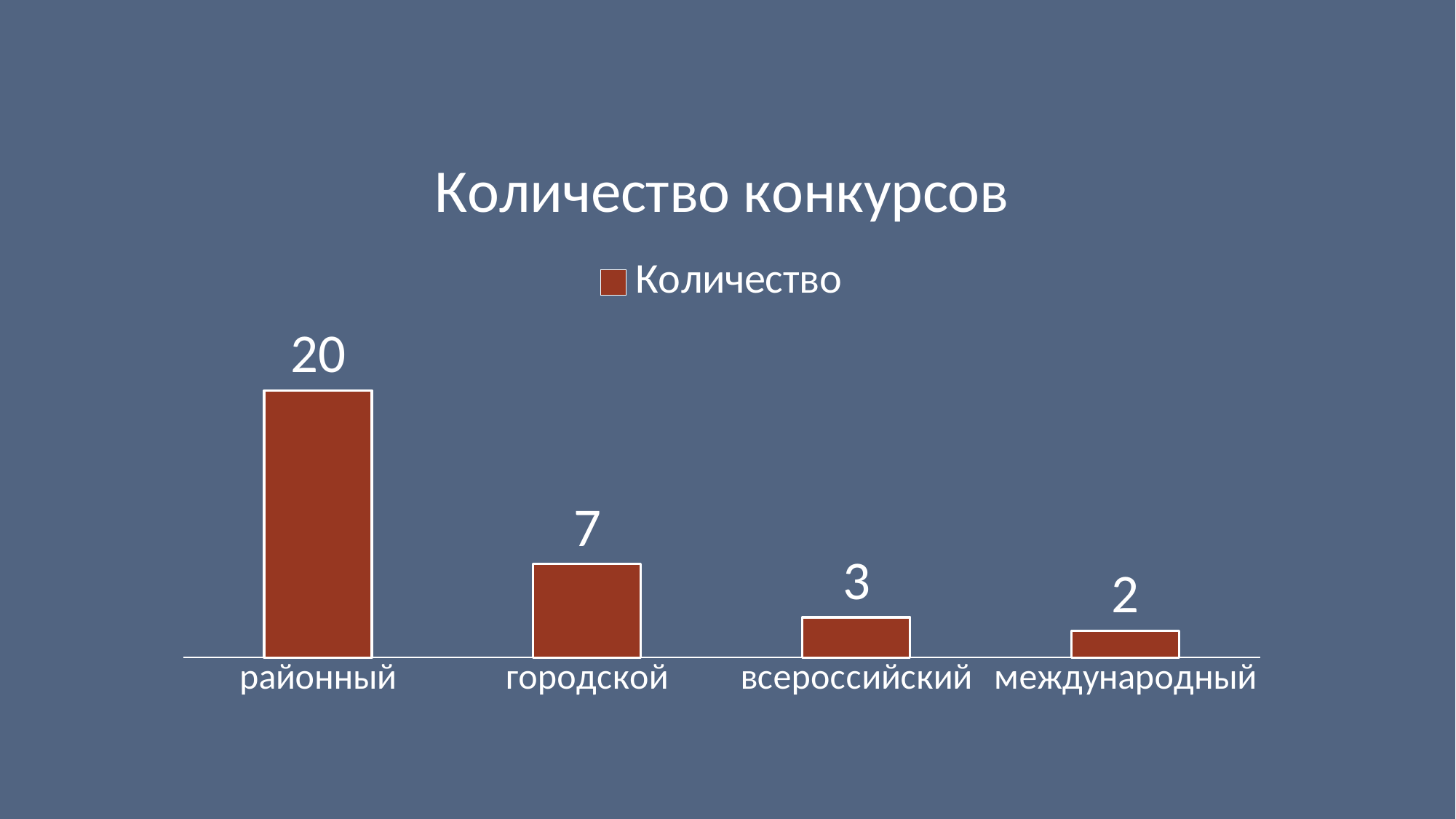
What is the value for районный? 20 What is the value for городской? 7 Which category has the lowest value? международный Which is larger, the value for городской or the value for всероссийский? городской What kind of chart is shown? bar chart How many categories are shown on the x axis? 4 Which category has the highest value? районный What is the value for всероссийский? 3 How many series does the legend list? 1 What is the difference between the values for районный and городской? 13 What is the title of the chart? Количество конкурсов What is the value for международный? 2